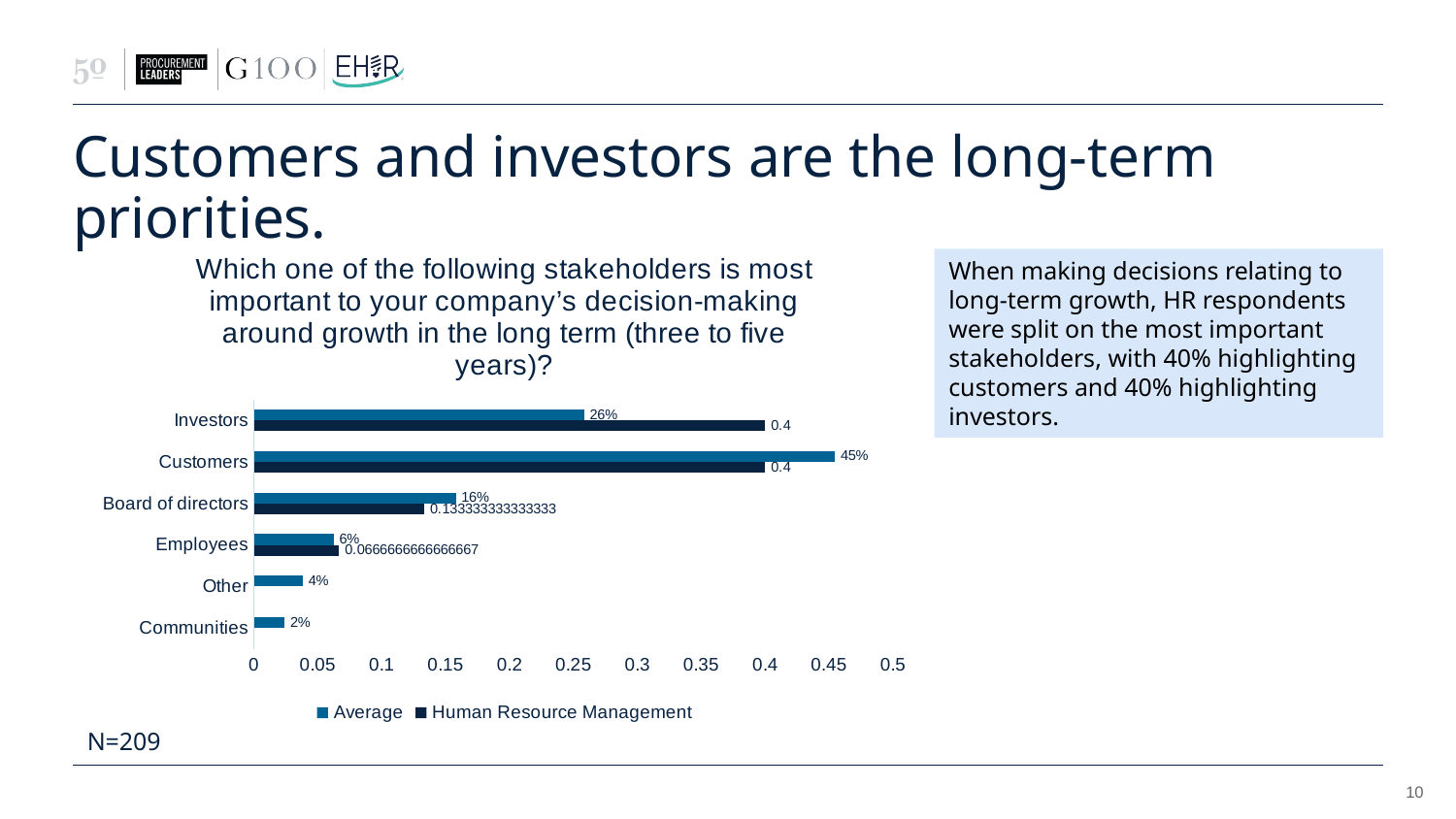
What kind of chart is shown on the slide? Bar chart What is the Human Resource Management value for Investors? 0.4 What is the Average value for Board of directors? 16% What is the difference between the Average values for Customers and Investors? 19% How many series does the legend list? 2 Which stakeholder has the lowest Average value? Communities How many stakeholder categories are shown on the chart? 6 Which stakeholder has the highest Average value? Customers What is the sample size (N) stated on the slide? N=209 What is the Average value for Customers? 45% What is the Human Resource Management value for Employees? 0.0666666666666667 Which has a larger Average value, Investors or Board of directors? Investors